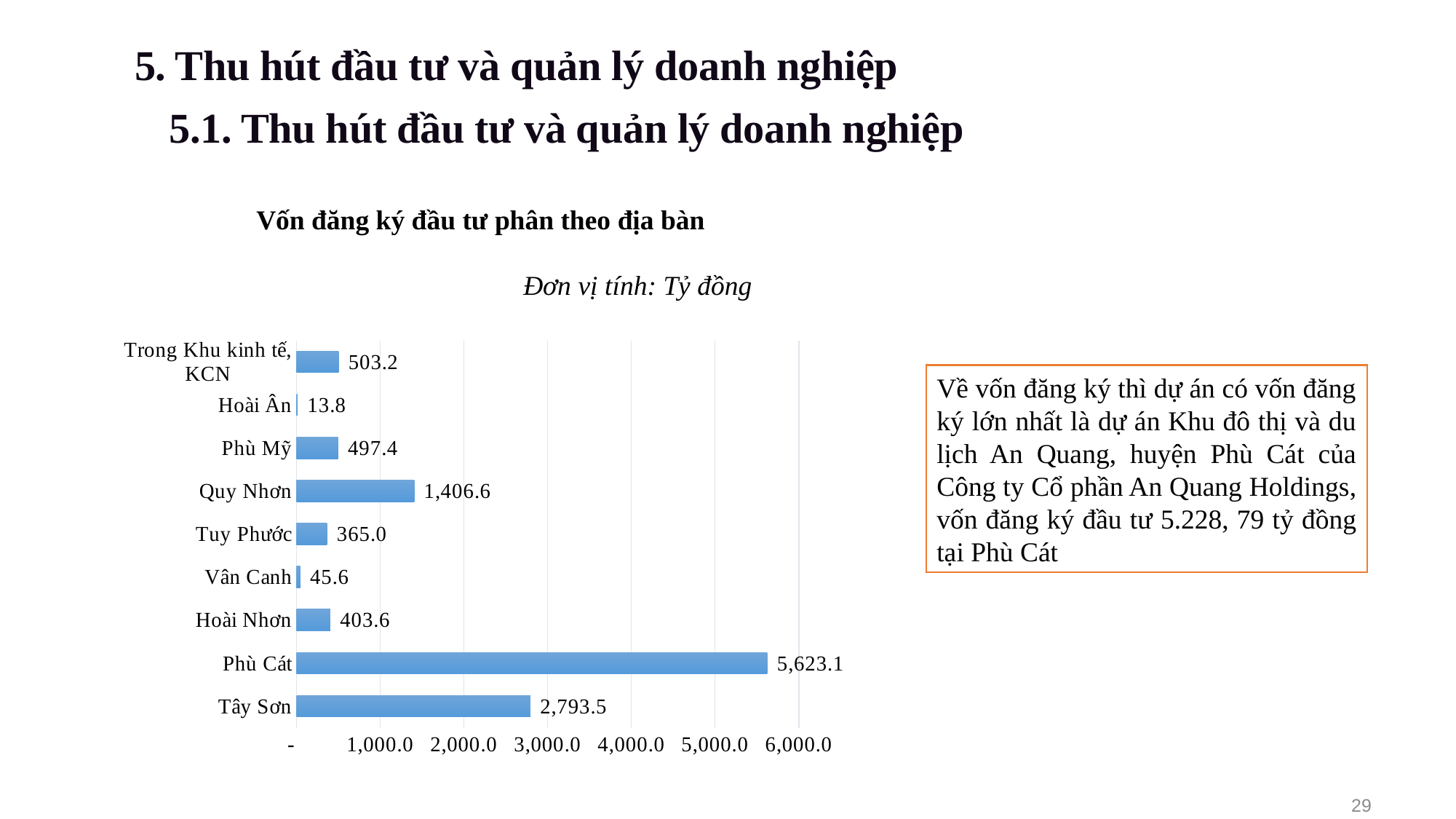
How many localities are shown in the chart? 9 What is the difference between the values for Quy Nhơn and Tuy Phước? 1,041.6 What is the value shown for Quy Nhơn? 1,406.6 What is the value shown for Trong Khu kinh tế, KCN? 503.2 What is the value shown for Vân Canh? 45.6 What unit of measurement is stated for the chart? Tỷ đồng Which locality has the lowest registered investment capital? Hoài Ân Which has a larger value, Hoài Nhơn or Tuy Phước? Hoài Nhơn Which locality has the highest registered investment capital? Phù Cát What type of chart is shown on the slide? Bar chart What is the registered investment capital for Phù Cát? 5,623.1 What is the difference between the values for Phù Cát and Tây Sơn? 2,829.6